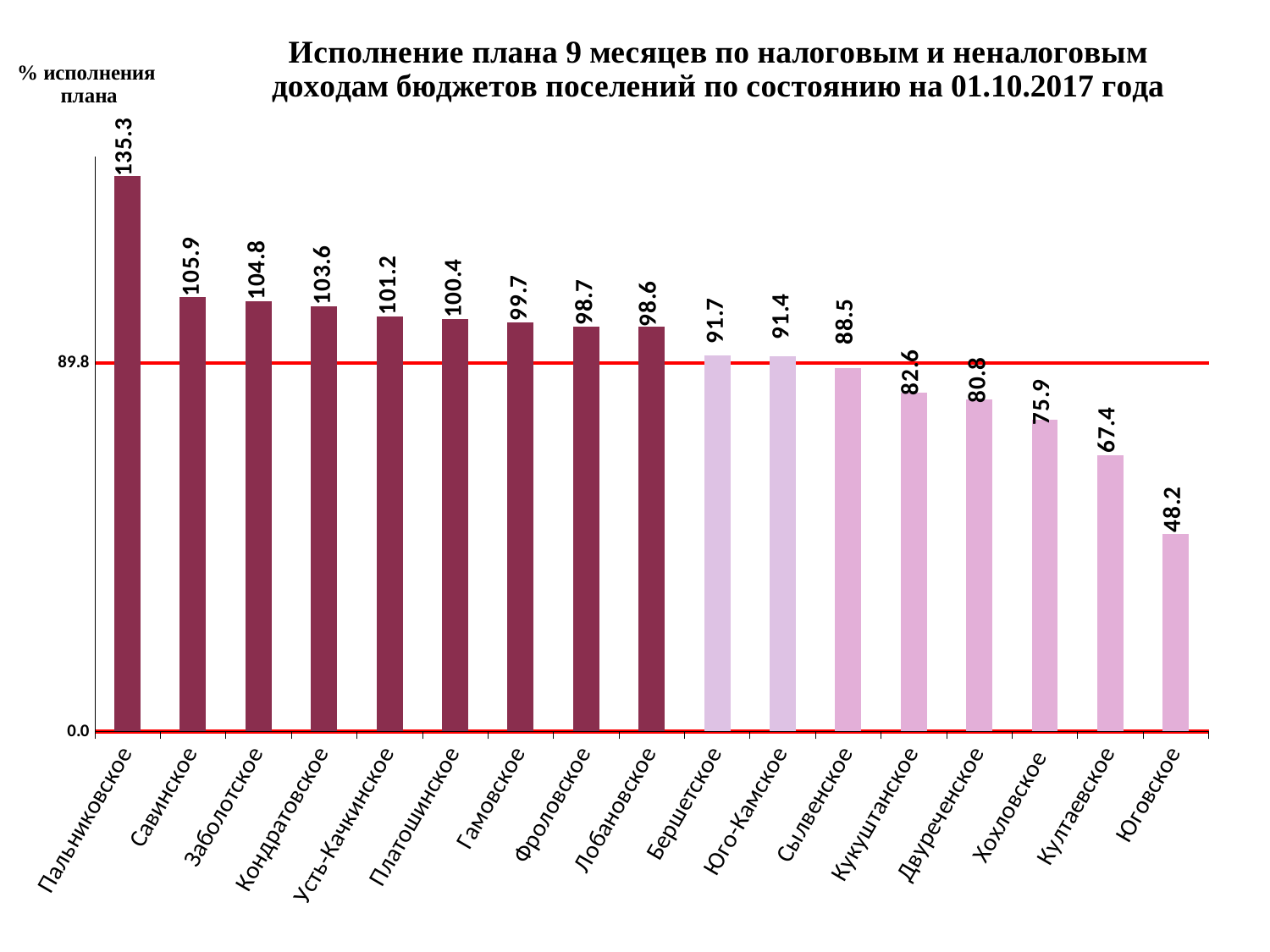
Do the values rise or fall from left to right along the x axis? fall What is the difference between the values for Савинское and Юговское? 57.7 What is the value for Пальниковское? 135.3 Which category has the highest value? Пальниковское What is the value for Хохловское? 75.9 Which is larger, the value for Кукуштанское or the value for Култаевское? Кукуштанское Which category has the lowest value? Юговское What is the difference between the values for Бершетское and Сылвенское? 3.2 What type of chart is shown on the slide? bar chart What value is marked by the horizontal red line across the chart? 89.8 What is the value for Юго-Камское? 91.4 How many categories are shown on the x axis? 17